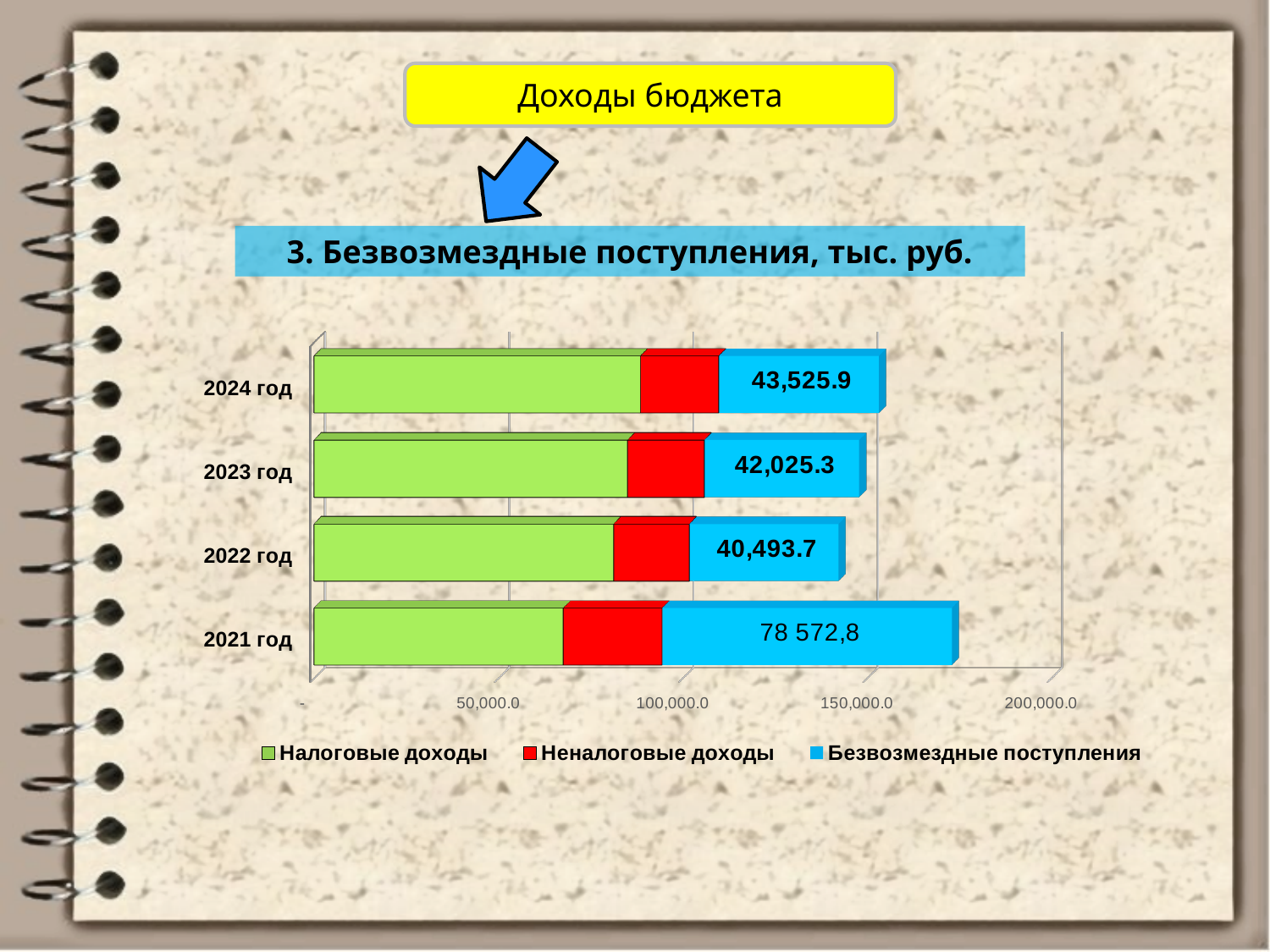
Which is larger, the Безвозмездные поступления value for 2023 год or for 2022 год? 2023 год What is the difference between the Безвозмездные поступления values for 2024 год and 2023 год? 1,500.6 What is the value of Безвозмездные поступления for 2022 год? 40,493.7 What kind of chart is shown on the slide? Stacked bar chart How many series does the legend list? 3 What is the value of Безвозмездные поступления for 2024 год? 43,525.9 Is the Налоговые доходы value for 2024 год greater or less than 50,000.0? greater How many years are shown on the chart? 4 Is the total length of the stacked bar for 2021 год greater or less than 150,000.0? greater What is the value of Безвозмездные поступления for 2021 год? 78 572,8 Which year has the lowest value of Безвозмездные поступления? 2022 год Which year has the highest value of Безвозмездные поступления? 2021 год